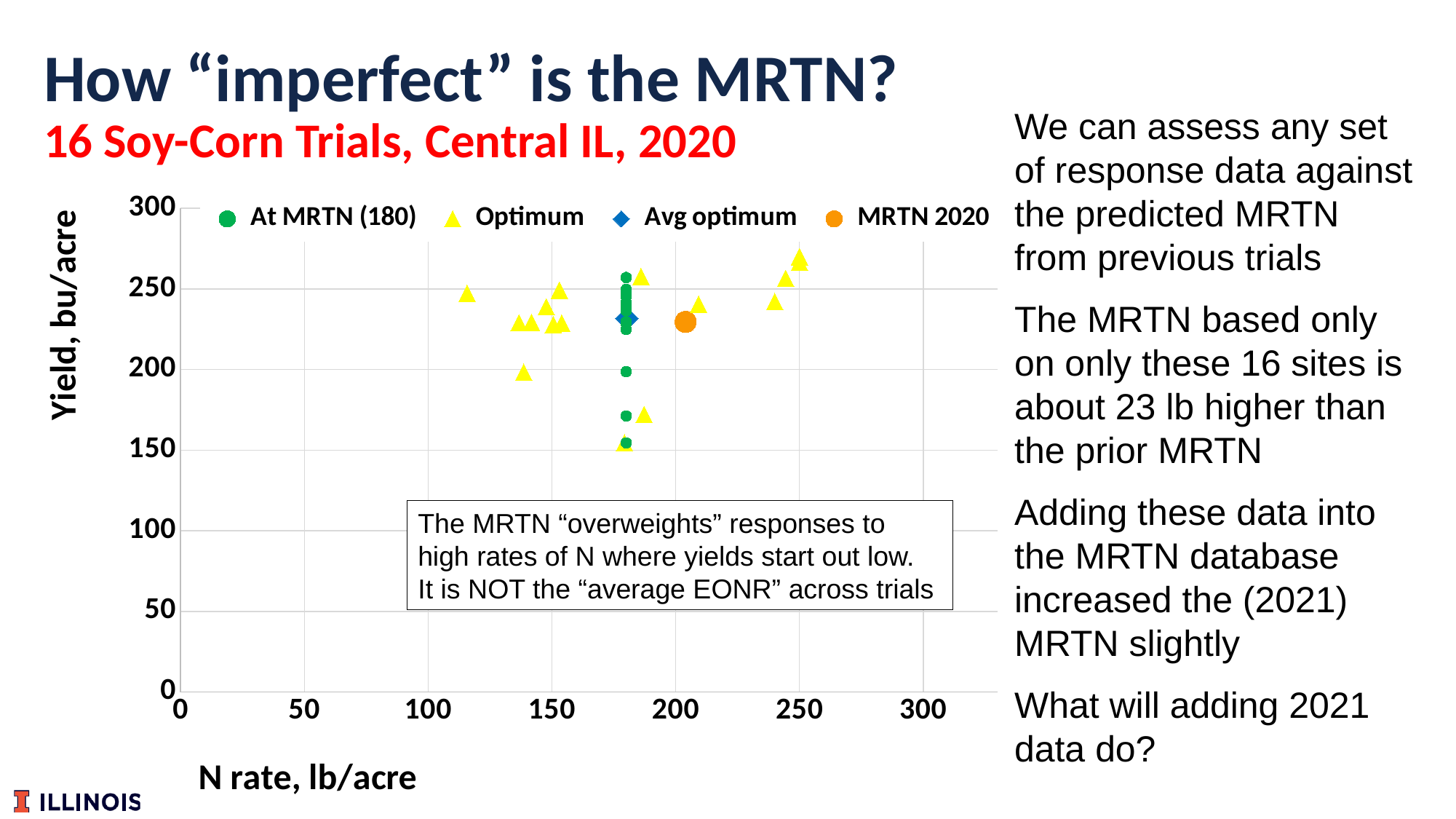
How many series does the chart legend list? 4 Is the N rate of the Avg optimum point greater or less than 200? less Is the yield of the Avg optimum point greater or less than 200? greater What is the label of the x axis of the chart? N rate, lb/acre What kind of chart is shown on the slide? scatter chart What is the label of the y axis of the chart? Yield, bu/acre Is the N rate of the Optimum point with the highest yield greater or less than 200? greater